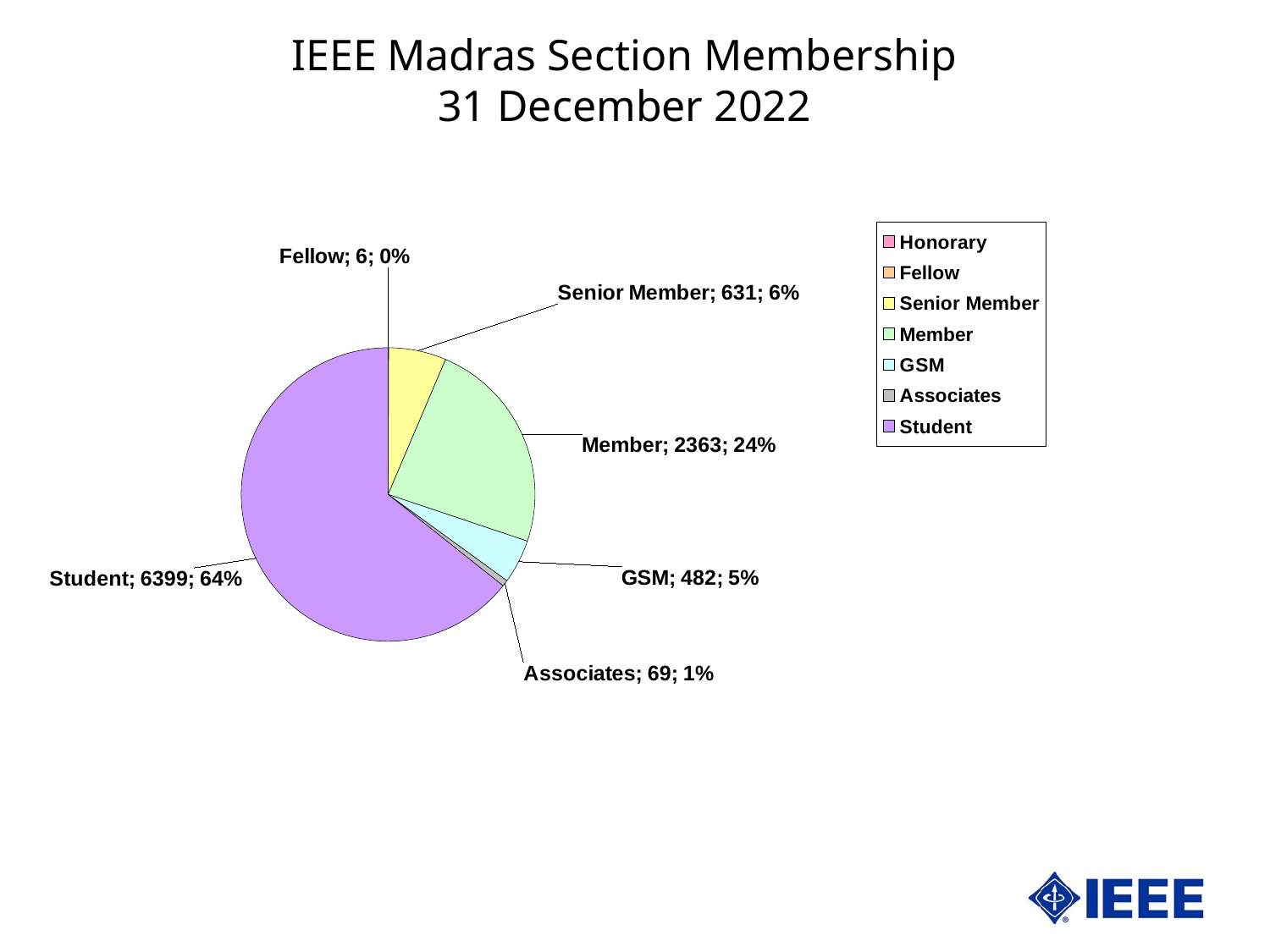
Which is larger, the GSM value or the Associates value? GSM What is the title of the chart? IEEE Madras Section Membership 31 December 2022 What is the value shown for GSM? 482 What is the value shown for Member? 2363 How many entries does the legend list? 7 Which labelled category has the smallest value? Fellow How many members are in the Student category? 6399 What percentage share does the Senior Member slice have? 6% What is the difference between the Member value and the Senior Member value? 1732 What percentage share does the Student slice have? 64% Which category has the largest slice of the pie? Student What type of chart is shown on the slide? pie chart